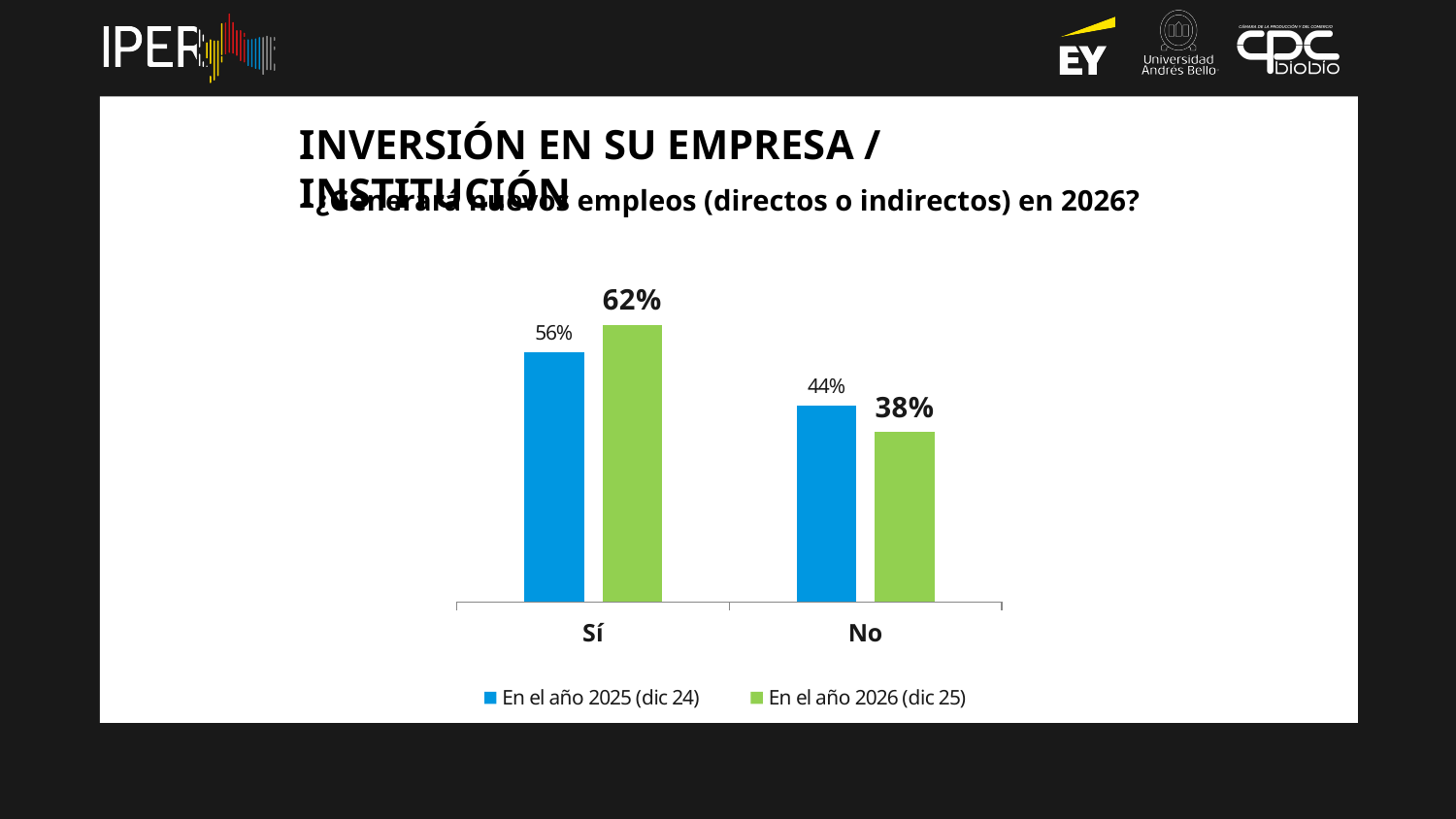
What is the difference between the "Sí" values for "En el año 2026 (dic 25)" and "En el año 2025 (dic 24)"? 6% How many categories are shown on the x axis of the chart? 2 How many series does the chart legend list? 2 Which category has the lowest value in the series "En el año 2025 (dic 24)"? No What is the value for "Sí" in the series "En el año 2026 (dic 25)"? 62% What is the value for "No" in the series "En el año 2025 (dic 24)"? 44% What kind of chart is shown on the slide? Bar chart For the category "No", which series has the larger value: "En el año 2025 (dic 24)" or "En el año 2026 (dic 25)"? En el año 2025 (dic 24) Which category has the highest value in the series "En el año 2026 (dic 25)"? Sí What is the difference between the "No" values for "En el año 2025 (dic 24)" and "En el año 2026 (dic 25)"? 6% What is the value for "Sí" in the series "En el año 2025 (dic 24)"? 56% What is the value for "No" in the series "En el año 2026 (dic 25)"? 38%